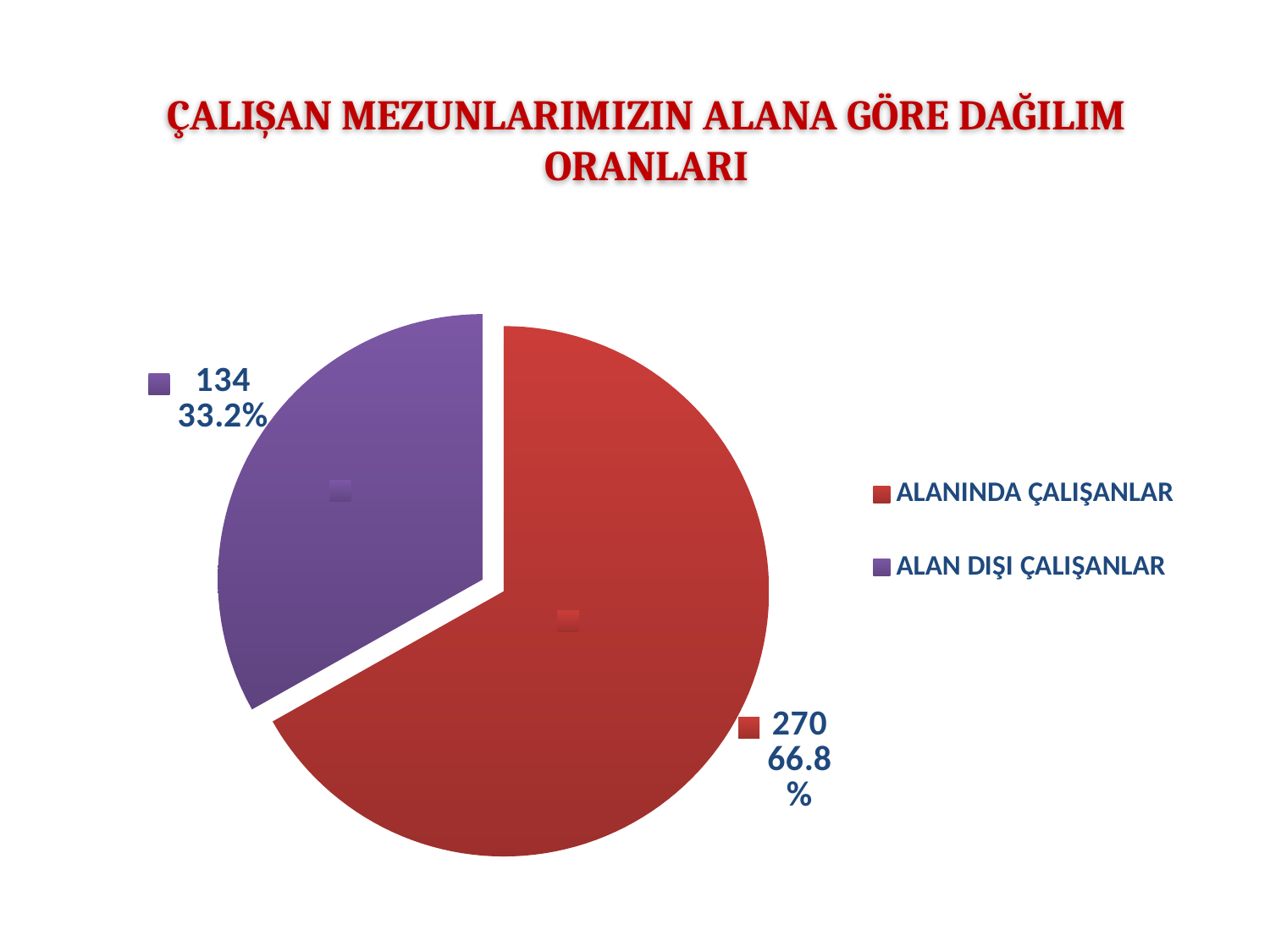
Which is larger, the value for ALANINDA ÇALIŞANLAR or ALAN DIŞI ÇALIŞANLAR? ALANINDA ÇALIŞANLAR What percentage share of the pie does ALANINDA ÇALIŞANLAR represent? 66.8% What type of chart is shown on the slide? pie chart What is the total of the two values shown in the pie chart? 404 What percentage share of the pie does ALAN DIŞI ÇALIŞANLAR represent? 33.2% What is the value for ALAN DIŞI ÇALIŞANLAR? 134 What colour is the slice for ALAN DIŞI ÇALIŞANLAR? purple Which category has the smallest slice of the pie? ALAN DIŞI ÇALIŞANLAR How many categories does the pie chart have? 2 What is the value for ALANINDA ÇALIŞANLAR? 270 What is the difference between the values for ALANINDA ÇALIŞANLAR and ALAN DIŞI ÇALIŞANLAR? 136 Which category has the largest slice of the pie? ALANINDA ÇALIŞANLAR